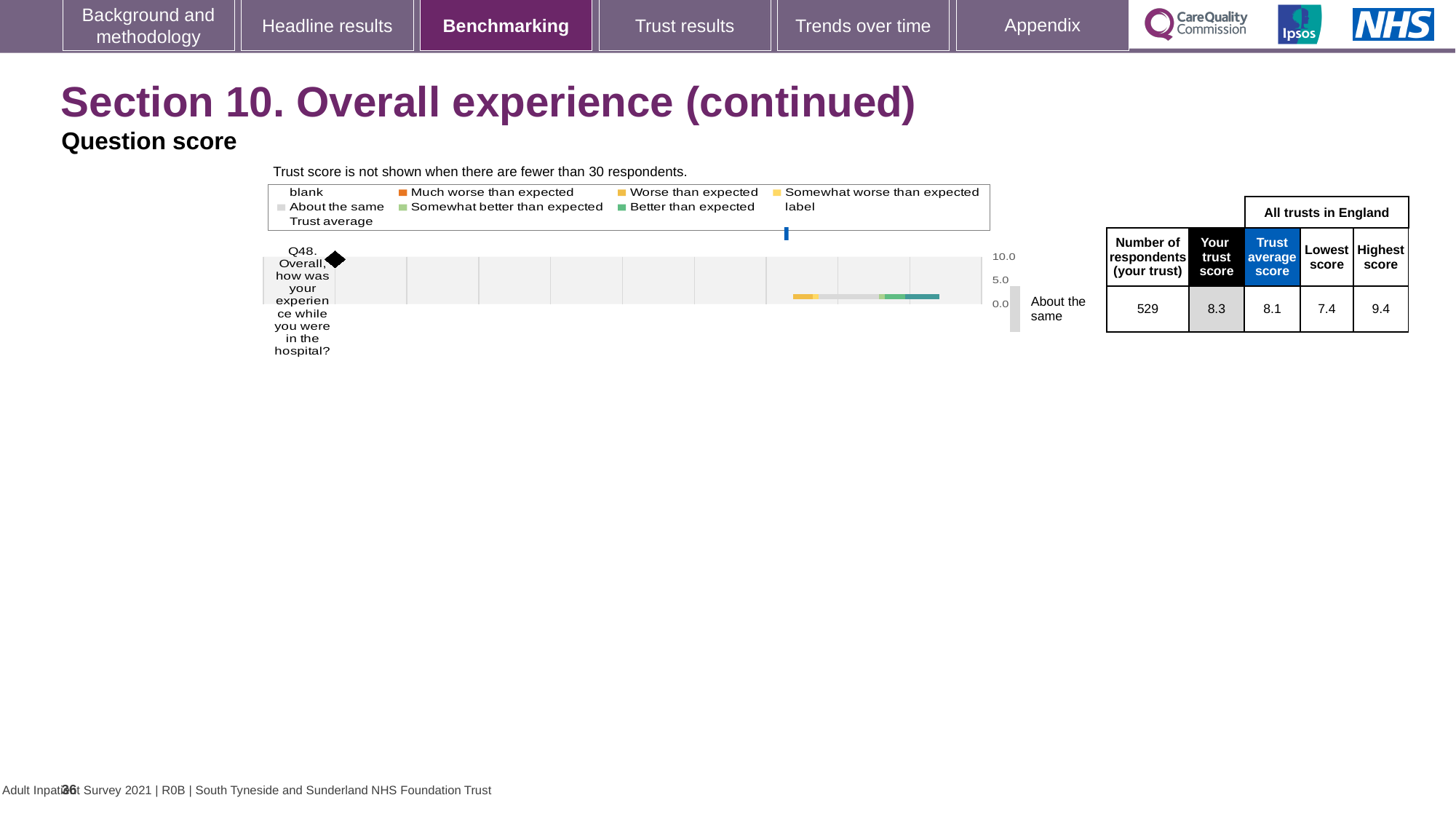
What is the highest value shown on the chart's score axis? 10.0 What kind of chart is used to show the Q48 benchmarking result? bar chart What is the highest score for Q48 among all trusts in England? 9.4 How many questions are plotted on the chart? 1 Which benchmarking category is shown next to the chart for Q48? About the same What is the difference between the highest and lowest scores for Q48 among all trusts in England? 2.0 What is the trust's score for Q48 in the table beside the chart? 8.3 What is the trust average score for Q48 across all trusts in England? 8.1 Which is larger for Q48: the trust's own score or the trust average score? the trust's own score How many respondents from the trust answered Q48? 529 What is the lowest score for Q48 among all trusts in England? 7.4 By how much does the trust's score for Q48 exceed the trust average score? 0.2